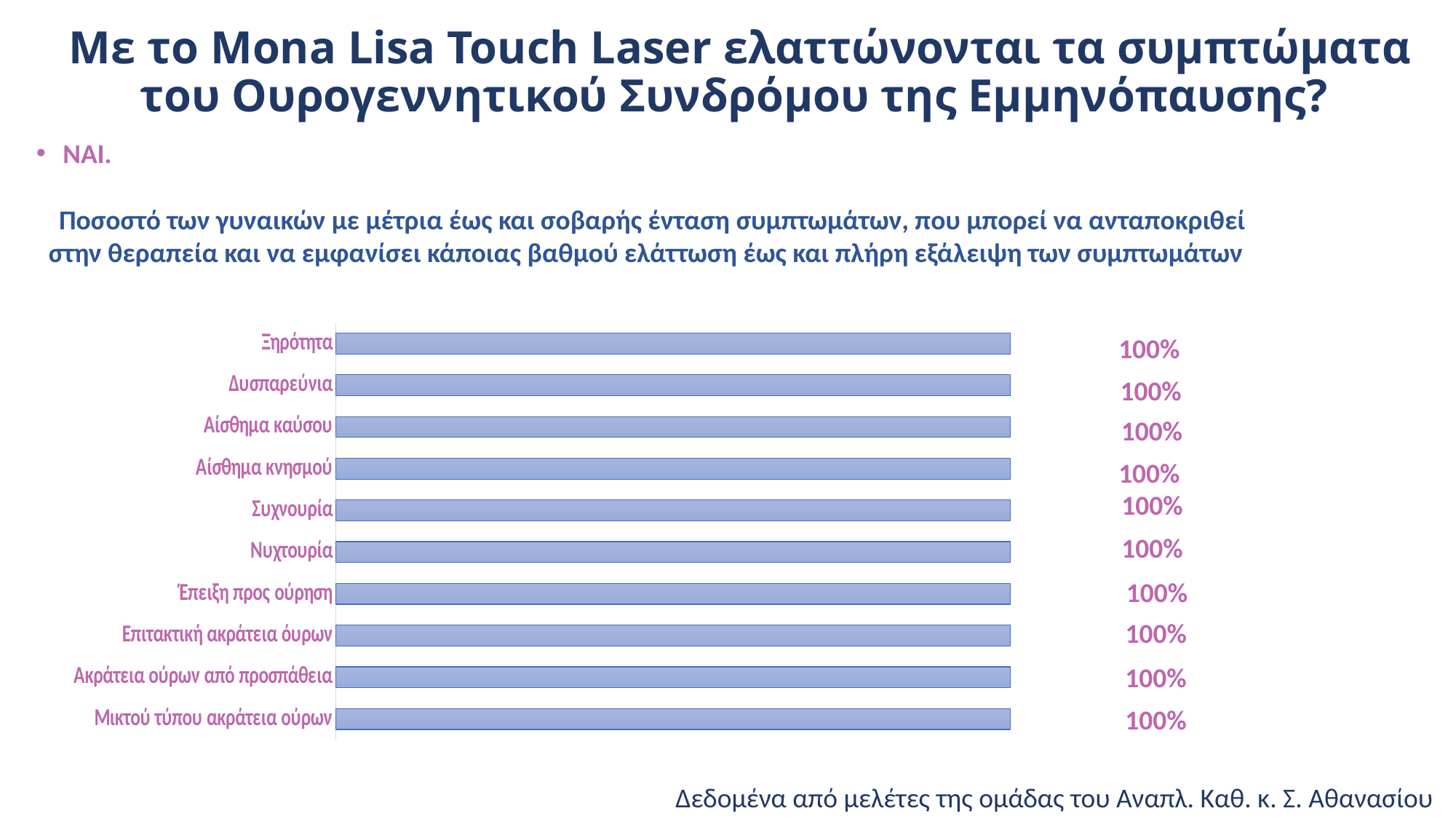
Is the value for Έπειξη προς ούρηση greater or less than 50%? greater What value is shown for Δυσπαρεύνια? 100% What value is shown for Ξηρότητα? 100% Which category is listed first (at the top) of the chart? Ξηρότητα What value is shown for Νυχτουρία? 100% Do all the bars in the chart have the same value? Yes, all are 100% What value is shown for Επιτακτική ακράτεια ούρων? 100% How many categories are plotted in the chart? 10 What value is shown for Μικτού τύπου ακράτεια ούρων? 100% What kind of chart is shown on the slide? Bar chart What is the difference between the values for Συχνουρία and Αίσθημα καύσου? 0%